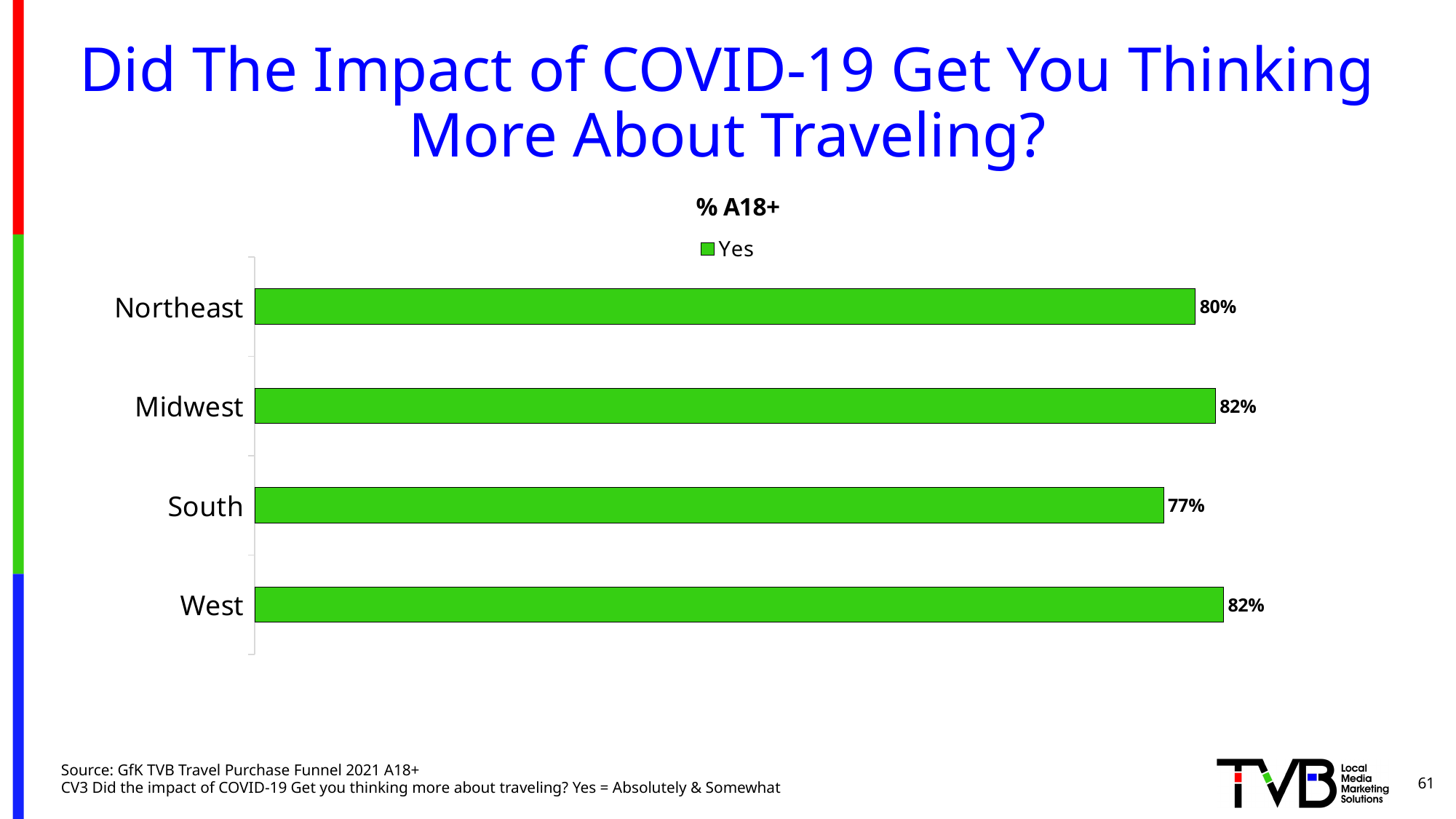
What kind of chart is shown on the slide? Bar chart What is the legend entry for the series in the chart? Yes What is the value shown for the Midwest? 82% What is the difference between the Midwest and South values? 5 percentage points What is the value shown for the West? 82% How many series does the legend list? 1 Which is larger, the value for the Northeast or the value for the South? Northeast What percentage of adults 18+ in the Northeast said yes? 80% Which region has the lowest percentage saying yes? South What is the difference between the Northeast and South values? 3 percentage points How many regions are shown in the chart? 4 What is the value shown for the South? 77%